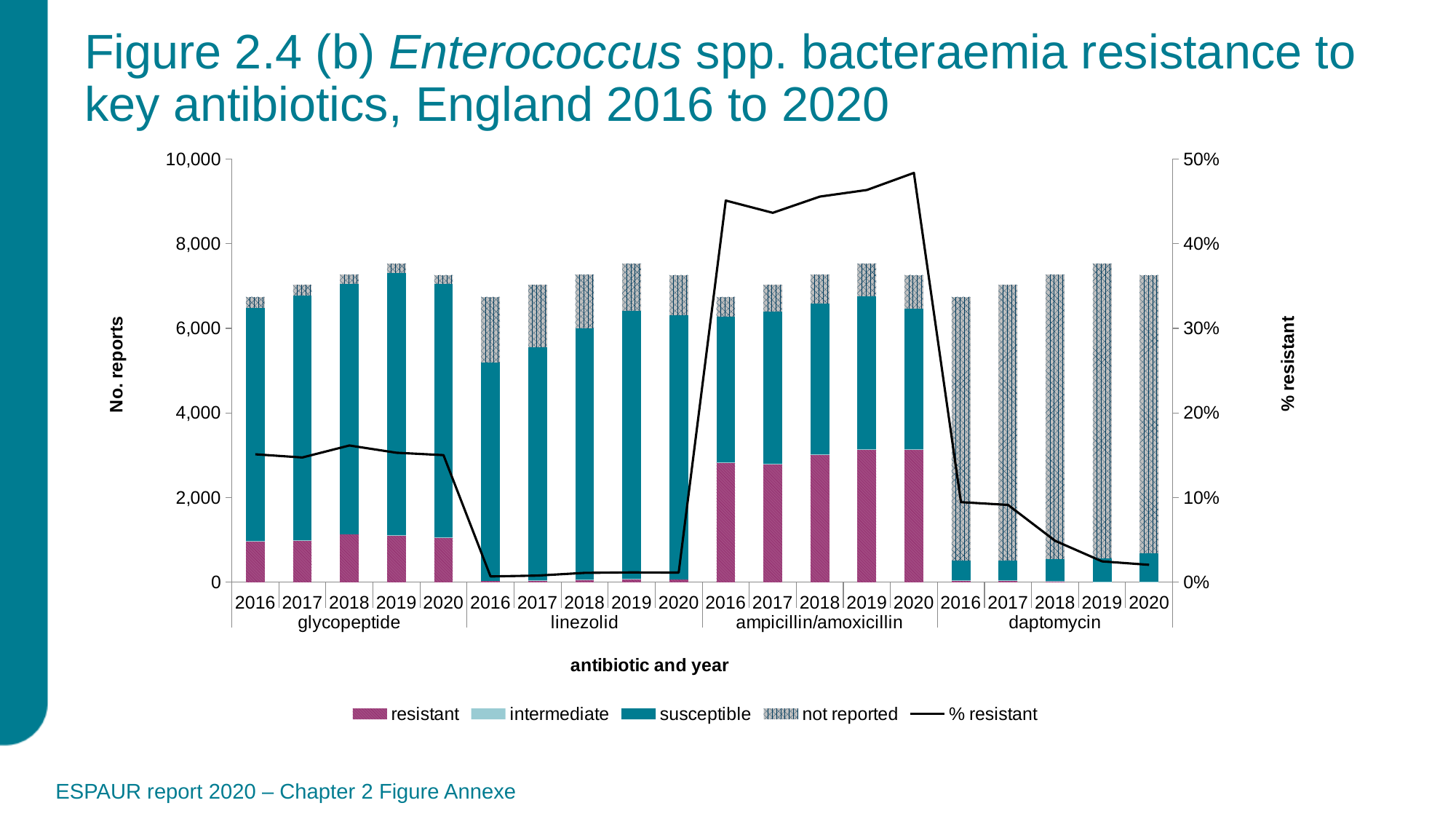
Which antibiotic has the highest % resistant line across the years shown? ampicillin/amoxicillin Is the % resistant value for glycopeptide in 2018 greater or less than 10%? greater Does the % resistant line for daptomycin rise or fall from 2016 to 2020? fall Is the total number of reports for glycopeptide in 2016 greater or less than 6,000? greater What kind of chart is used to show the number of reports? bar chart How many years are shown for each antibiotic? 5 What is the title of the right-hand vertical axis? % resistant How many antibiotics are shown along the x axis? 4 How many entries does the legend list? 5 Which has the larger resistant segment in 2016: glycopeptide or ampicillin/amoxicillin? ampicillin/amoxicillin Is the % resistant value for linezolid in 2016 greater or less than 10%? less